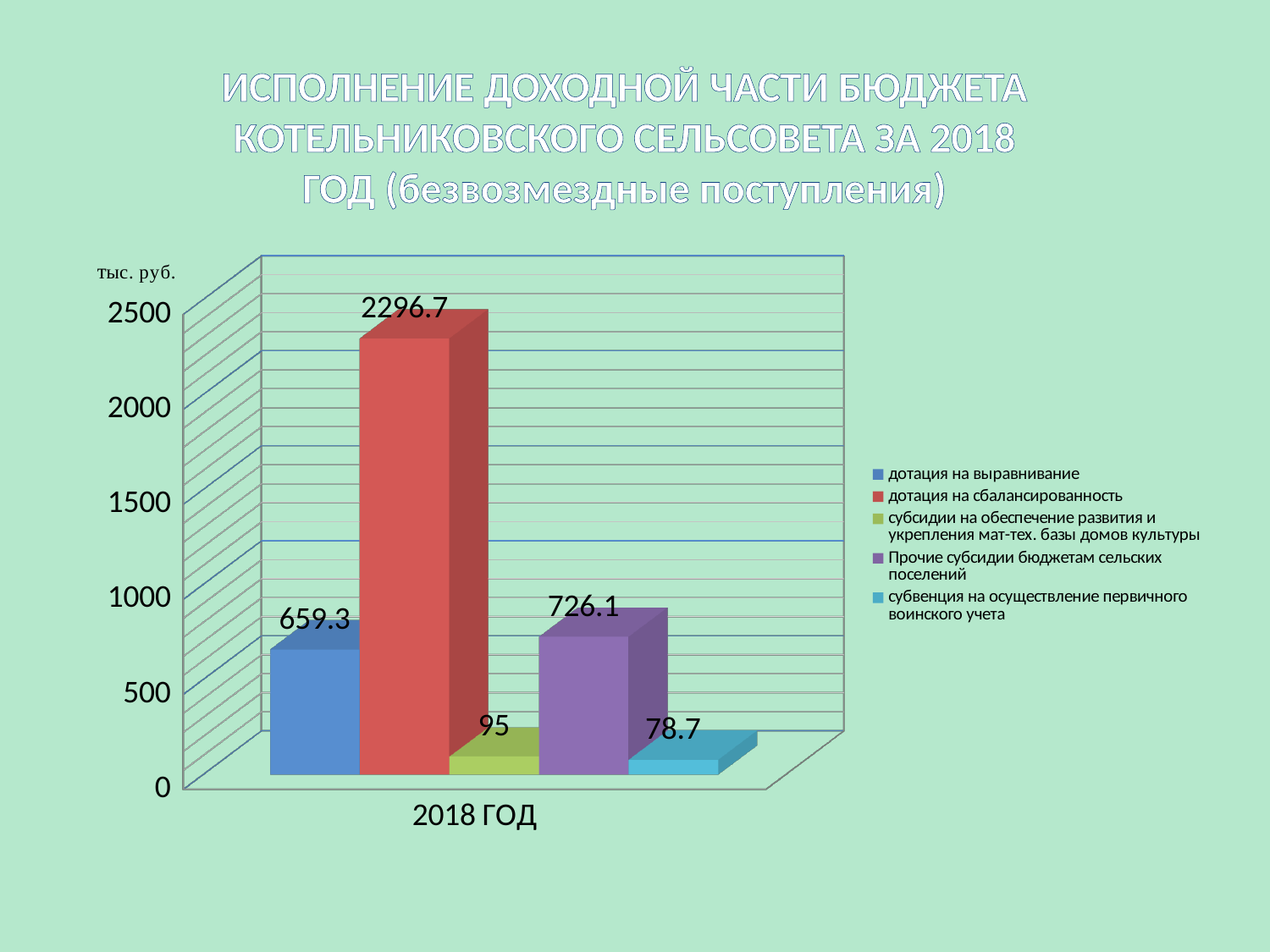
How many series does the legend list? 5 Which series has the highest value? дотация на сбалансированность What unit is shown on the vertical axis label? тыс. руб. What is the value for Прочие субсидии бюджетам сельских поселений? 726.1 What kind of chart is shown on the slide? bar chart Which series has the lowest value? субвенция на осуществление первичного воинского учета Which is larger: дотация на выравнивание or Прочие субсидии бюджетам сельских поселений? Прочие субсидии бюджетам сельских поселений Is the value for дотация на сбалансированность greater or less than 2000? greater What is the value for дотация на сбалансированность? 2296.7 What is the value for дотация на выравнивание? 659.3 What is the value for субвенция на осуществление первичного воинского учета? 78.7 What is the difference between дотация на сбалансированность and Прочие субсидии бюджетам сельских поселений? 1570.6